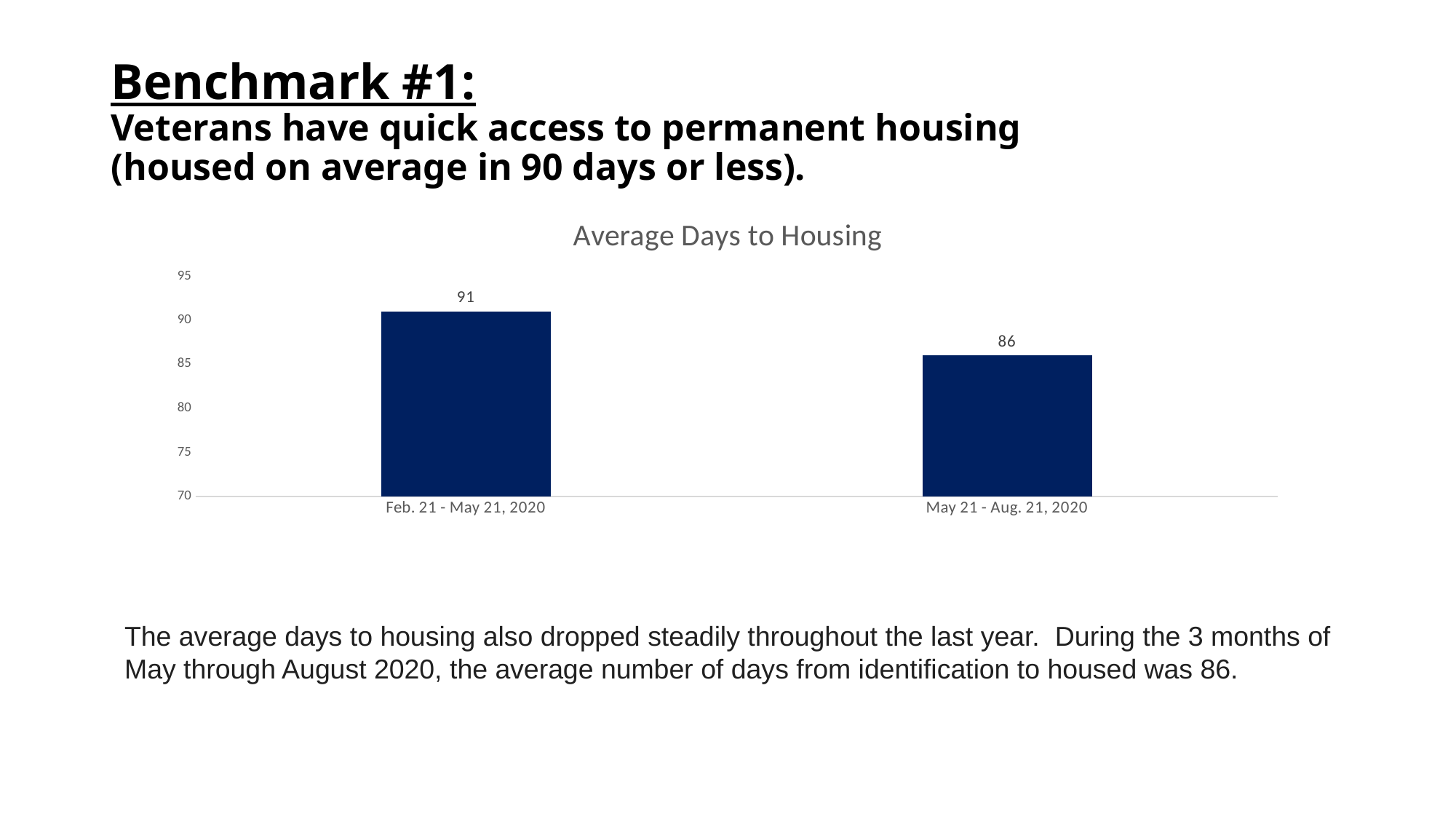
Which period has the highest average days to housing? Feb. 21 - May 21, 2020 What kind of chart is shown on the slide? bar chart What is the average days to housing for May 21 - Aug. 21, 2020? 86 Which period has the lowest average days to housing? May 21 - Aug. 21, 2020 Do the values rise or fall from the first period to the second? fall Is the value for Feb. 21 - May 21, 2020 greater or less than 90? greater What is the difference in average days to housing between Feb. 21 - May 21, 2020 and May 21 - Aug. 21, 2020? 5 What is the average days to housing for Feb. 21 - May 21, 2020? 91 What is the title of the chart? Average Days to Housing How many periods are shown in the chart? 2 Is the value for May 21 - Aug. 21, 2020 greater or less than 90? less Which period has a larger value: Feb. 21 - May 21, 2020 or May 21 - Aug. 21, 2020? Feb. 21 - May 21, 2020